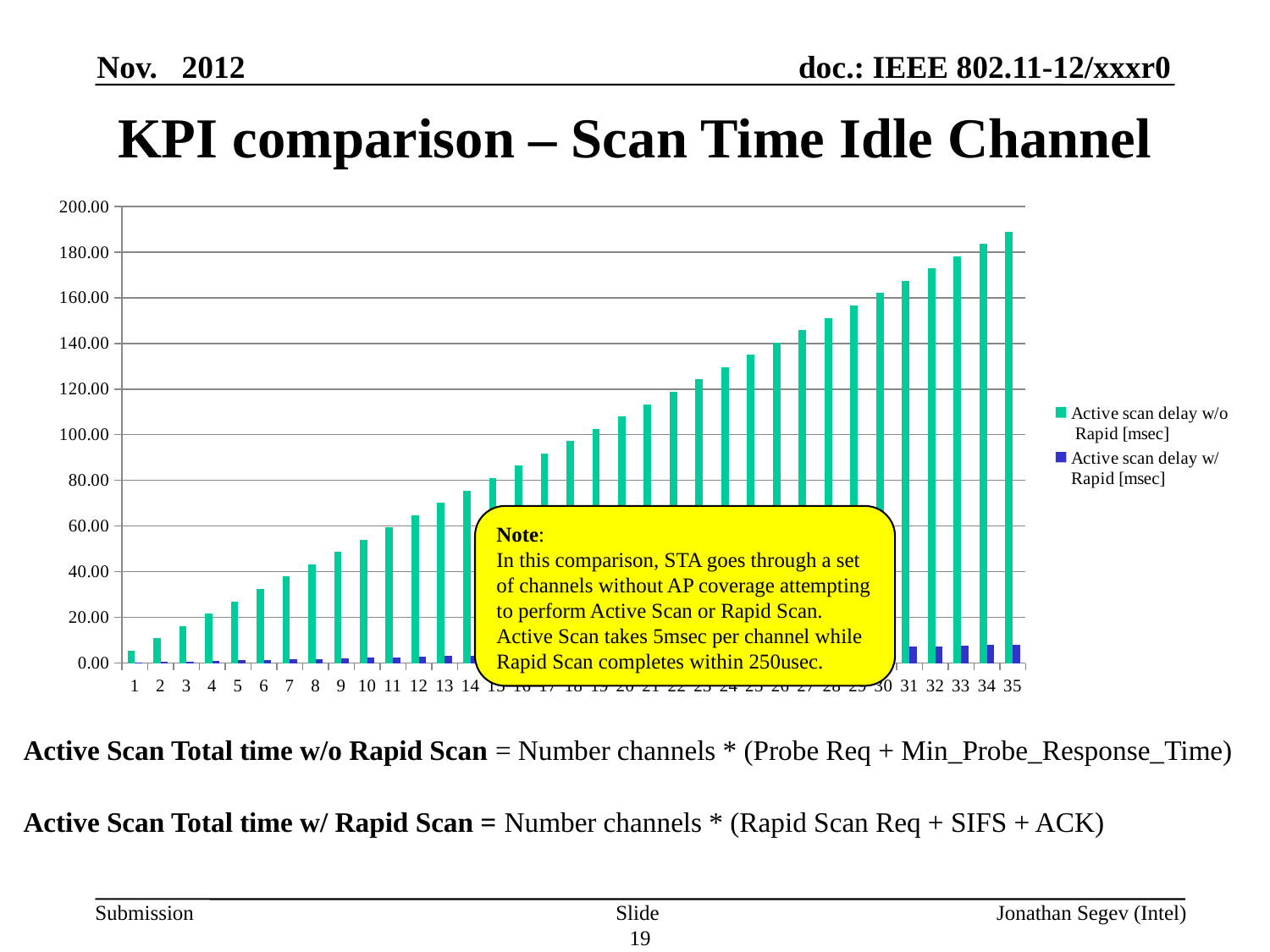
Is the value for 'Active scan delay w/o Rapid [msec]' at category 20 greater or less than 100? greater Is the value for 'Active scan delay w/ Rapid [msec]' at category 30 greater or less than 20? less Do the values for 'Active scan delay w/o Rapid [msec]' rise or fall as the category number increases along the x axis? rise Is the value for 'Active scan delay w/o Rapid [msec]' at category 35 greater or less than 180? greater How many series does the legend list? 2 At category 35, which series has the larger value: 'Active scan delay w/o Rapid [msec]' or 'Active scan delay w/ Rapid [msec]'? Active scan delay w/o Rapid [msec] What are the two series names listed in the legend? Active scan delay w/o Rapid [msec]; Active scan delay w/ Rapid [msec] What kind of chart is shown on the slide? bar chart Which category has the highest value for 'Active scan delay w/o Rapid [msec]'? 35 How many categories are shown along the x axis? 35 Which category has the lowest value for 'Active scan delay w/o Rapid [msec]'? 1